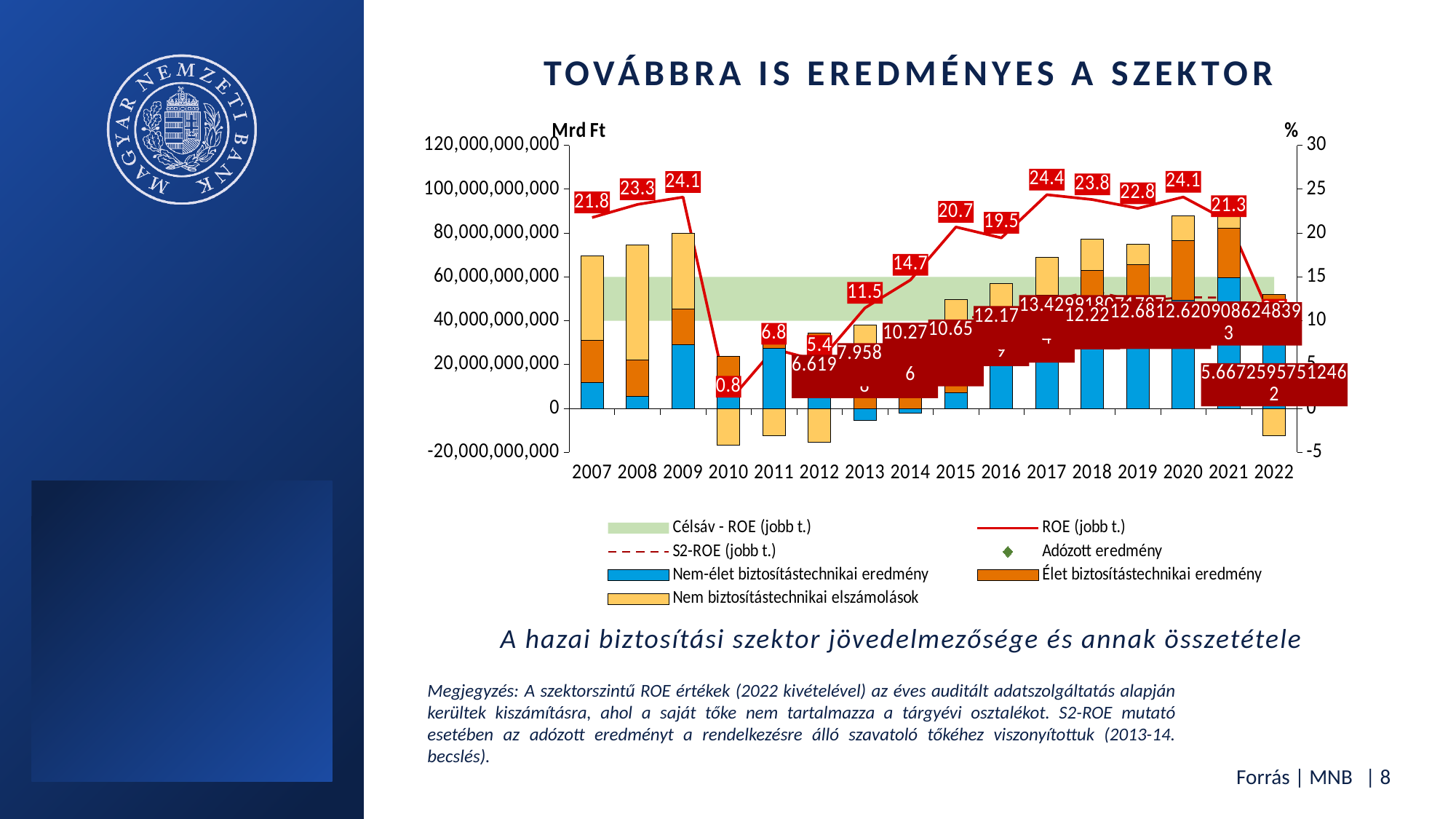
What is the ROE (jobb t.) value shown for 2017? 24.4 Does the ROE (jobb t.) line rise or fall from 2013 to 2017? rise What kind of chart is shown on the slide? Stacked bar chart combined with line series Is the value of Nem biztosítástechnikai elszámolások for 2010 greater or less than 0? less How many entries does the chart legend list? 7 What is the ROE (jobb t.) value shown for 2014? 14.7 In which year is the labelled ROE (jobb t.) value the lowest? 2010 How many years are shown on the x axis of the chart? 16 By how many percentage points did the ROE (jobb t.) fall from 2009 to 2010? 23.3 Which year has the higher ROE (jobb t.) value, 2015 or 2016? 2015 In which year is the labelled ROE (jobb t.) value the highest? 2017 What is the ROE (jobb t.) value shown for 2010? 0.8